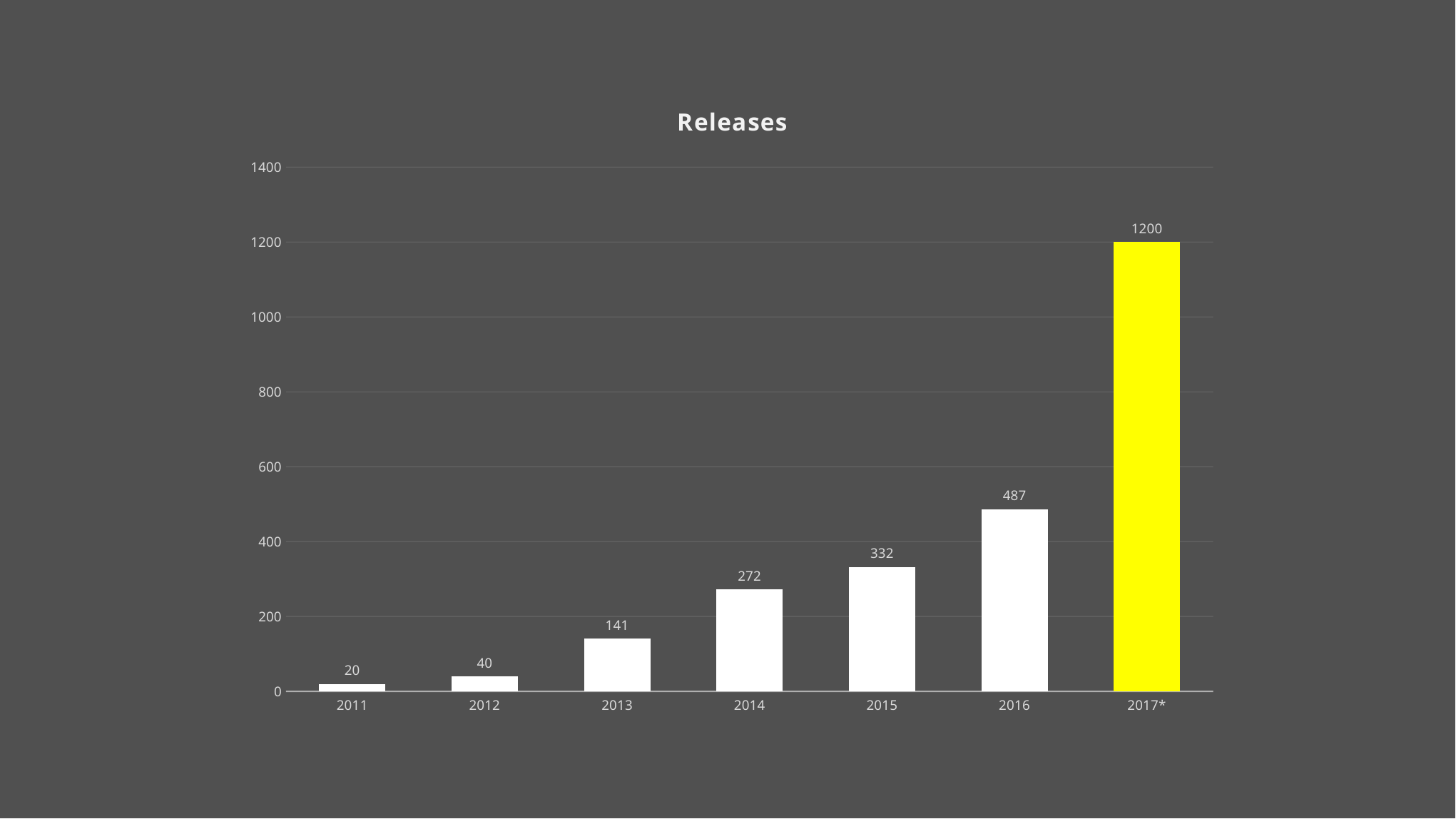
What is the value for 2014? 272 What is the difference between the values for 2016 and 2015? 155 What is the value for 2017*? 1200 What kind of chart is this? bar chart Which year has the highest value? 2017* Which is larger, the value for 2013 or the value for 2012? 2013 How many years are shown on the x axis? 7 Do the values rise or fall from 2011 to 2017*? rise Which year has the lowest value? 2011 What is the difference between the values for 2017* and 2016? 713 Is the value for 2016 greater or less than 400? greater What is the value for 2011? 20